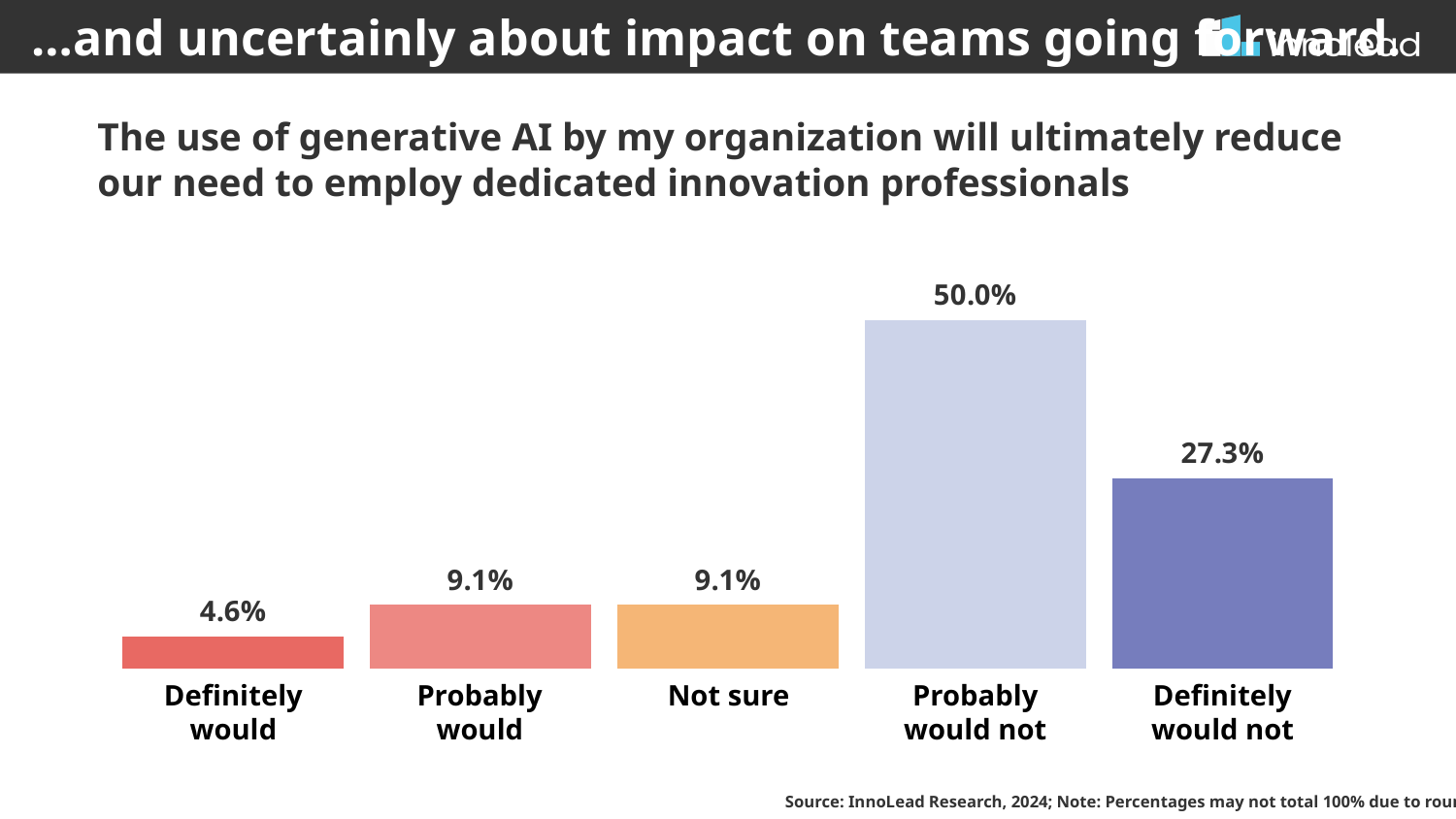
How many response categories are shown in the chart? 5 Which is larger, "Definitely would not" or "Not sure"? Definitely would not What is the source cited for the chart data? InnoLead Research, 2024 What is the value for "Definitely would not"? 27.3% What is the value for "Not sure"? 9.1% What percentage of respondents answered "Probably would not"? 50.0% What is the difference between "Probably would not" and "Definitely would not"? 22.7% What is the value for "Definitely would"? 4.6% What kind of chart is shown on the slide? Bar chart Which response category has the highest value? Probably would not What is the difference between "Probably would" and "Definitely would"? 4.5% Which response category has the lowest value? Definitely would